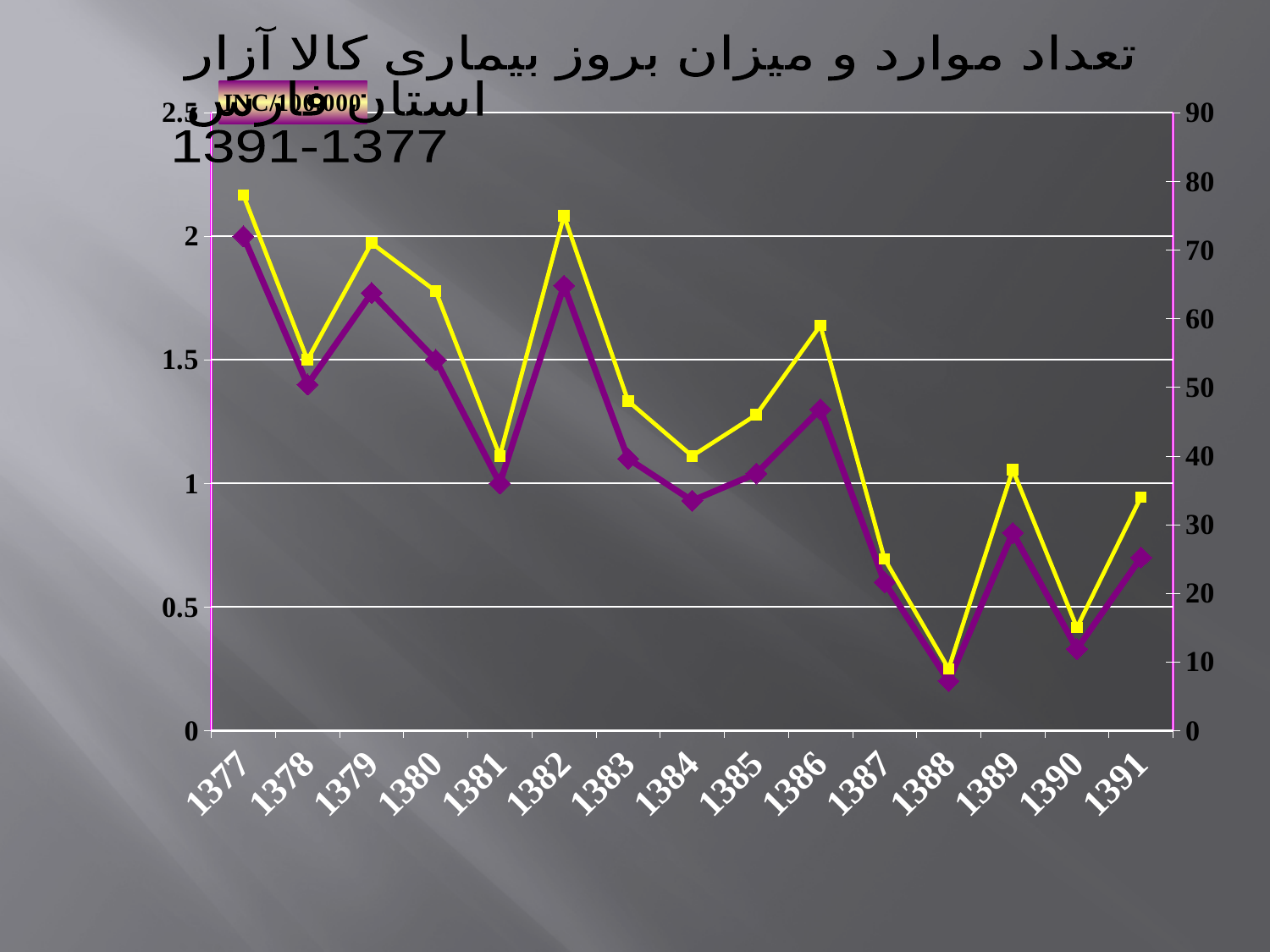
Is the value of the yellow line in 1386 greater or less than 50 on the right axis? greater In which year does the purple line reach its highest point? 1377 Overall, do the plotted values rise or fall from 1377 to 1391? fall What kind of chart is shown on the slide? line chart Which year has the higher value on the purple line, 1382 or 1383? 1382 Which year has the higher value on the yellow line, 1379 or 1380? 1379 In which year does the purple line reach its lowest point? 1388 Is the value of the purple line in 1388 greater or less than 0.5 on the left axis? less Is the value of the purple line in 1379 greater or less than 1.5 on the left axis? greater How many years are shown along the x axis of the chart? 15 In which year does the yellow line reach its lowest point? 1388 How many lines (series) are plotted on the chart? 2